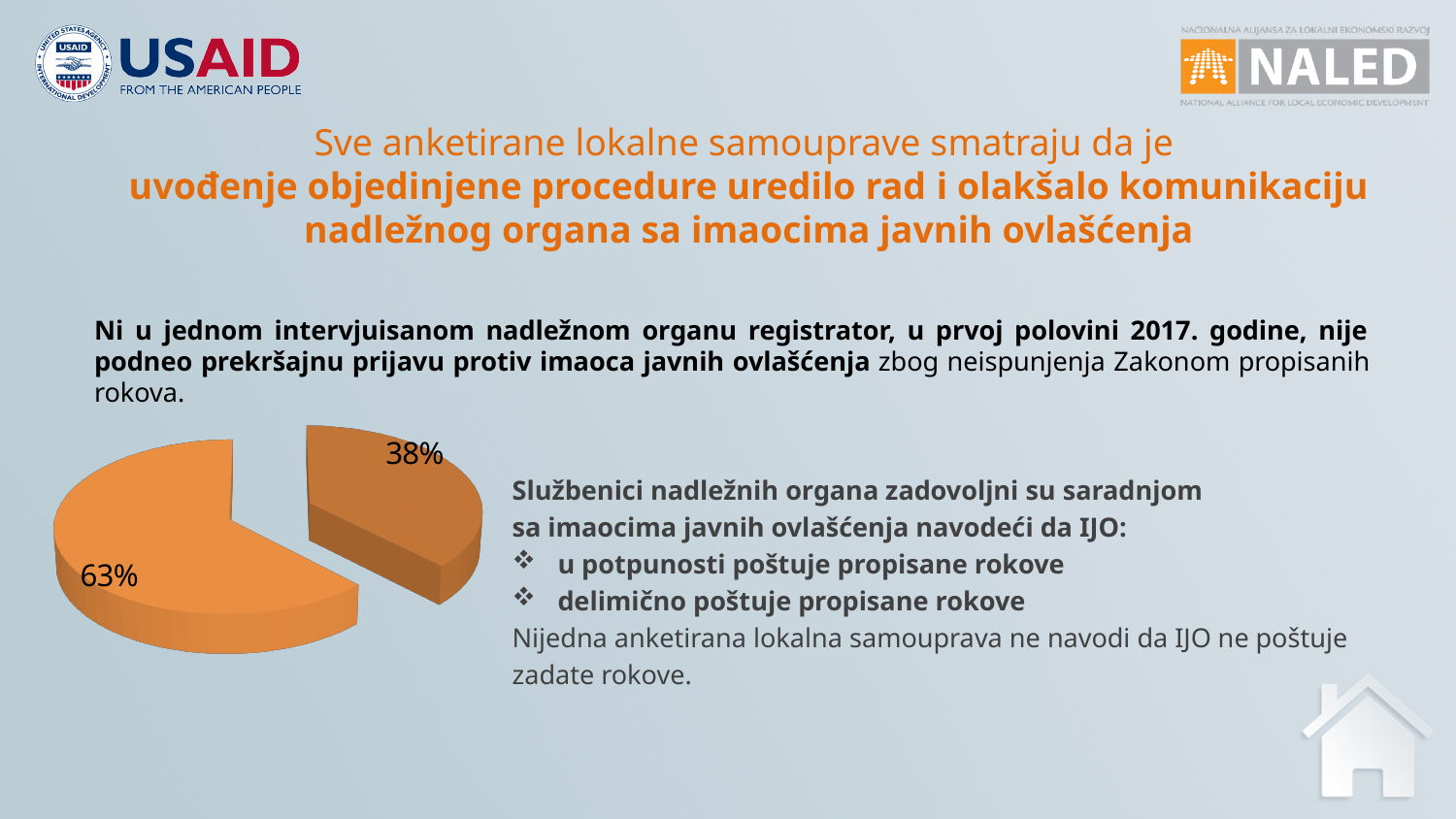
What is the value of the smallest slice of the pie chart? 38% What share of the pie does the smaller, separated slice represent? 38% How many slices does the pie chart have? 2 Does the pie chart have a legend? No What kind of chart is shown on the slide? pie chart What is the value of the largest slice of the pie chart? 63% Which slice of the pie chart is larger, the one labelled 63% or the one labelled 38%? 63% Is the larger slice of the pie chart greater or less than 50%? greater What is the difference between the two slice values shown on the pie chart? 25 percentage points What colour are the slices of the pie chart? orange